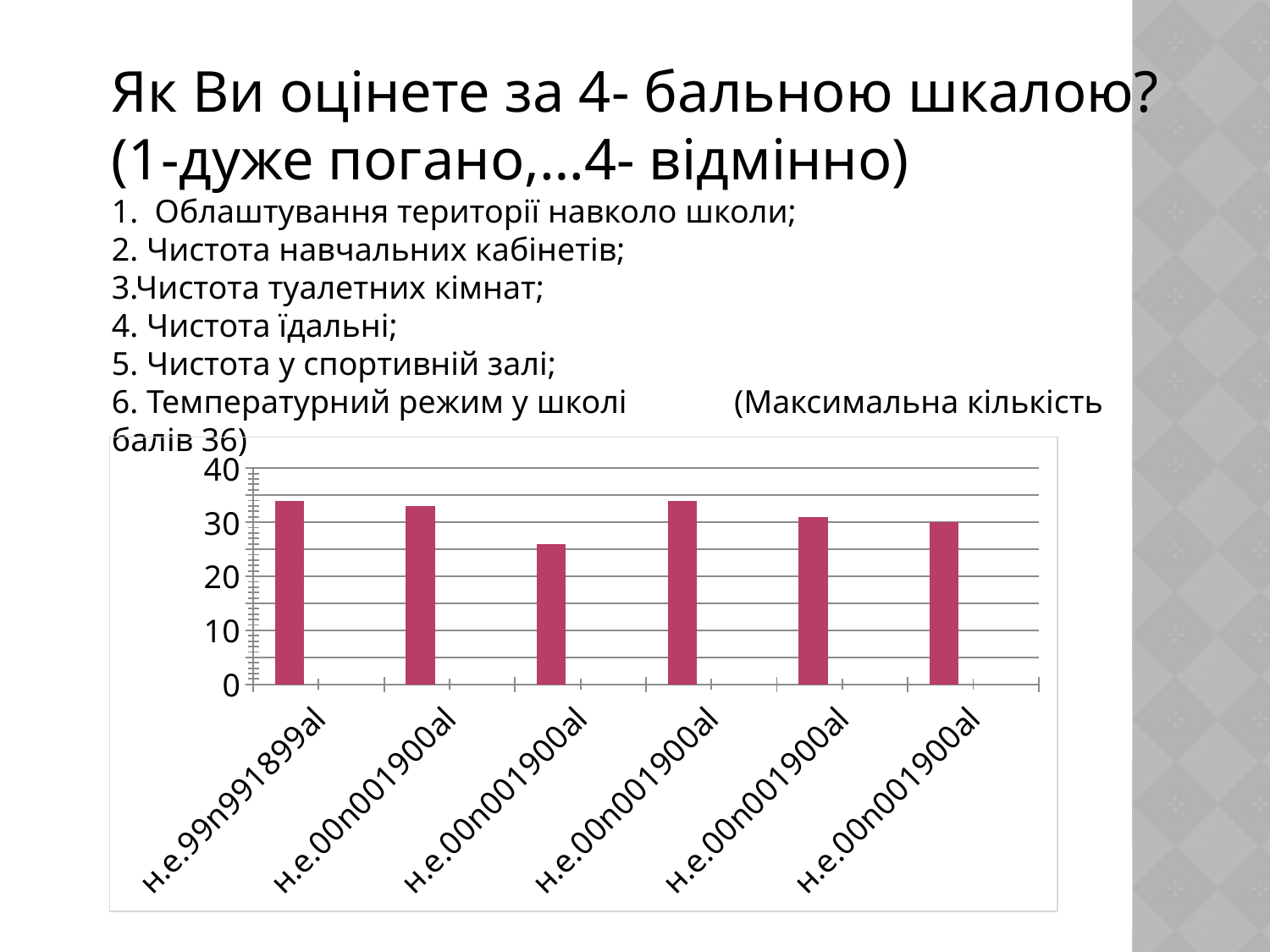
What is the highest value shown on the vertical axis? 40 Is the value of the second bar from the left greater or less than 30? greater Is the value of the fourth bar from the left greater or less than 40? less Which is larger, the first bar from the left or the third bar from the left? the first bar Which is larger, the third bar from the left or the sixth bar from the left? the sixth bar What kind of chart is shown on the slide? bar chart How many bars does the chart show? 6 Is the value of the first bar from the left greater or less than 30? greater Which bar is the lowest in the chart, counting from the left? the third bar What colour are the bars in the chart? dark pink